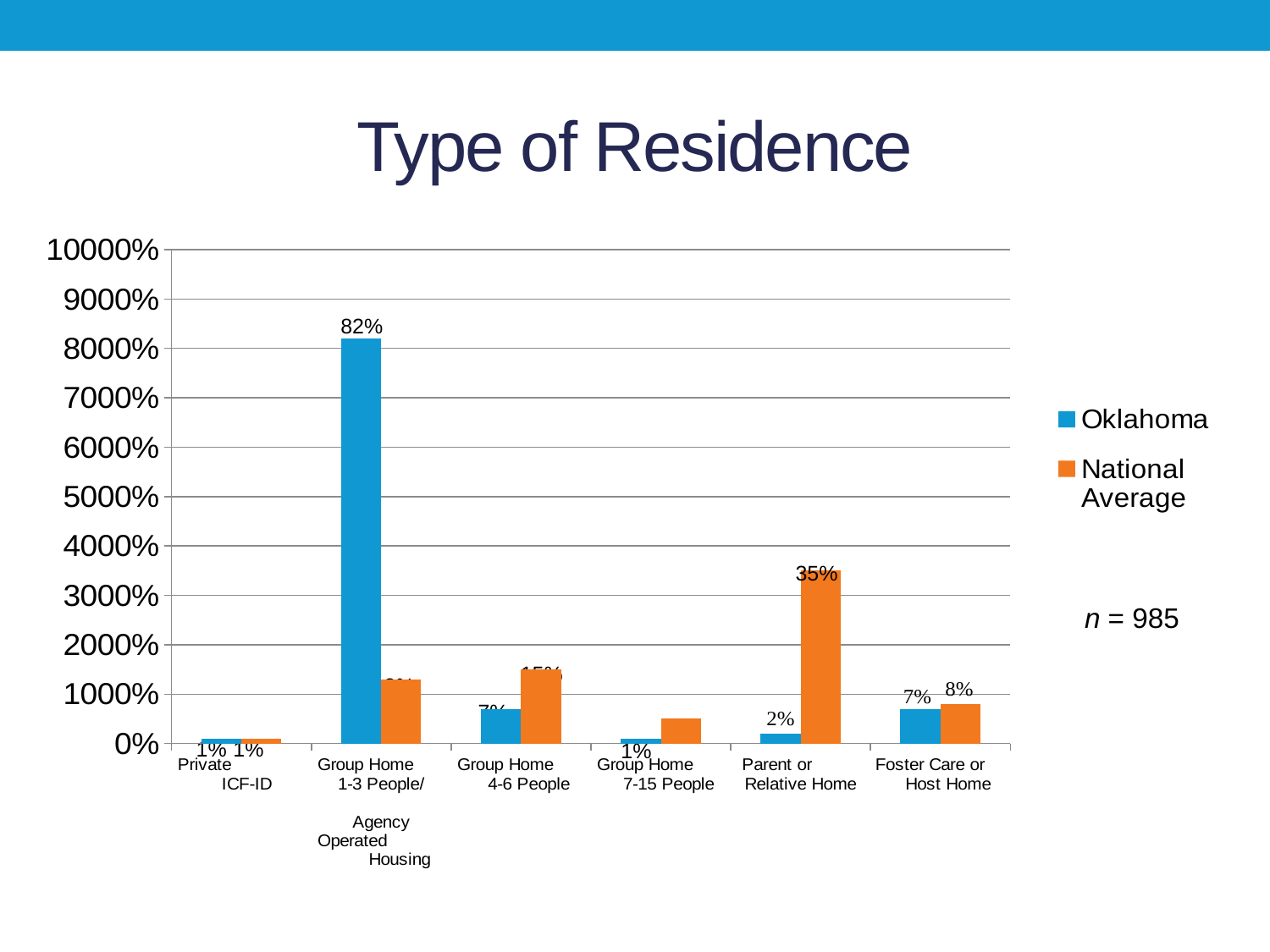
What is the National Average value for Parent or Relative Home? 35% Which type of residence has the highest Oklahoma value? Group Home 1-3 People/Agency Operated Housing How many series does the legend list? 2 What is the sample size (n) stated on the slide? 985 Which type of residence has the highest National Average value? Parent or Relative Home For Parent or Relative Home, how much higher is the National Average than the Oklahoma value? 33% What is the Oklahoma value for Parent or Relative Home? 2% How many types of residence are shown on the x axis? 6 What is the National Average value for Foster Care or Host Home? 8% What is the Oklahoma value for Private ICF-ID? 1% For Foster Care or Host Home, which is larger: the Oklahoma value or the National Average? National Average What is the Oklahoma value for Group Home 1-3 People/Agency Operated Housing? 82%